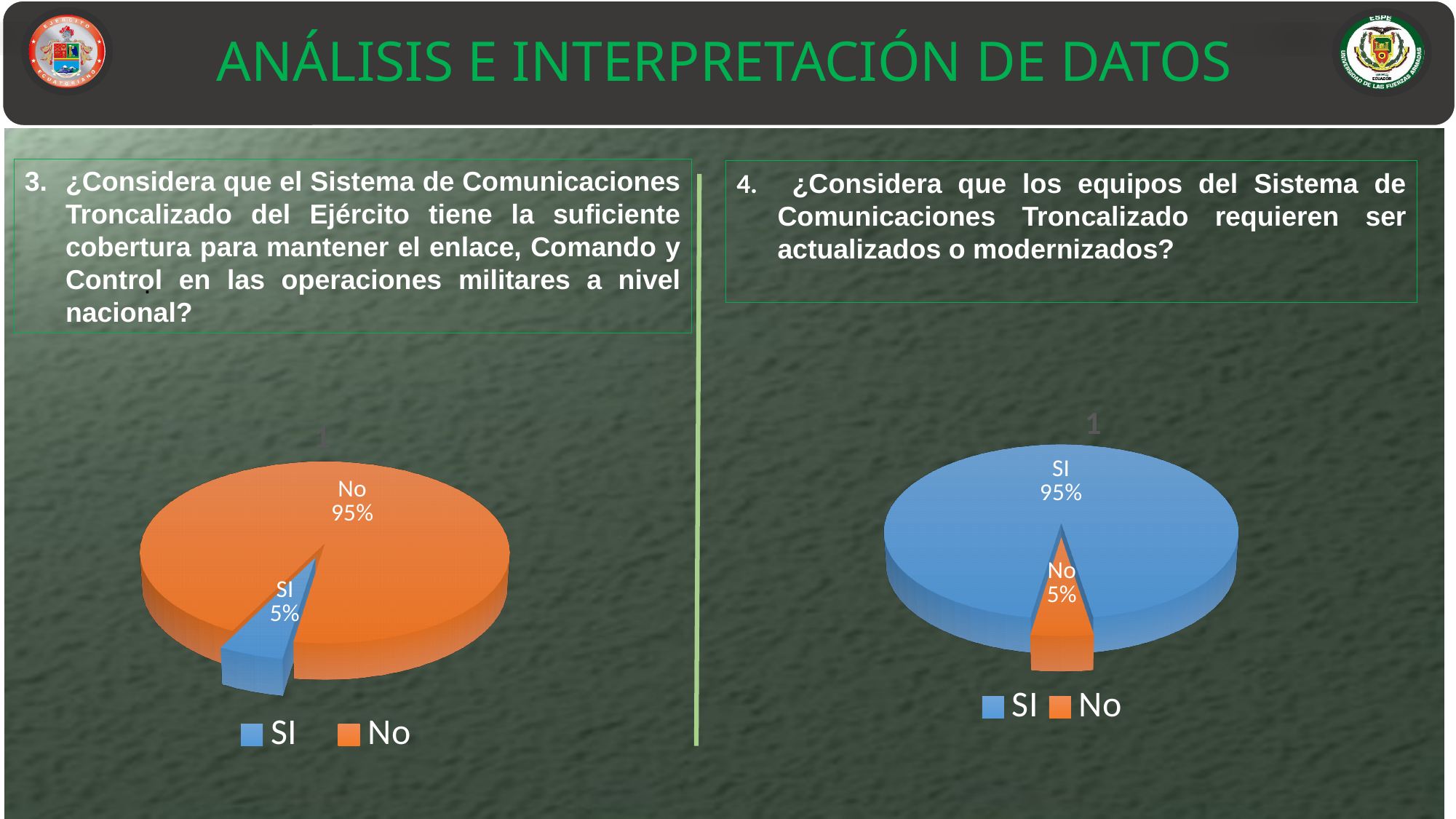
What type of chart is used on the left side of the slide (question 3)? Pie chart In the left pie chart (question 3), what percentage of respondents answered SI? 5% In the right pie chart (question 4), which is larger, SI or No? SI In the right pie chart (question 4), which category has the smallest share? No In the left pie chart (question 3), which category has the largest share? No In the left pie chart (question 3), what percentage of respondents answered No? 95% In the right pie chart (question 4), what percentage of respondents answered No? 5% In the right pie chart (question 4), what colour represents the No category? Orange How many categories does the legend of the right pie chart (question 4) list? 2 In the left pie chart (question 3), what is the difference in percentage points between No and SI? 90 In the left pie chart (question 3), what colour represents the SI category? Blue In the right pie chart (question 4), what percentage of respondents answered SI? 95%